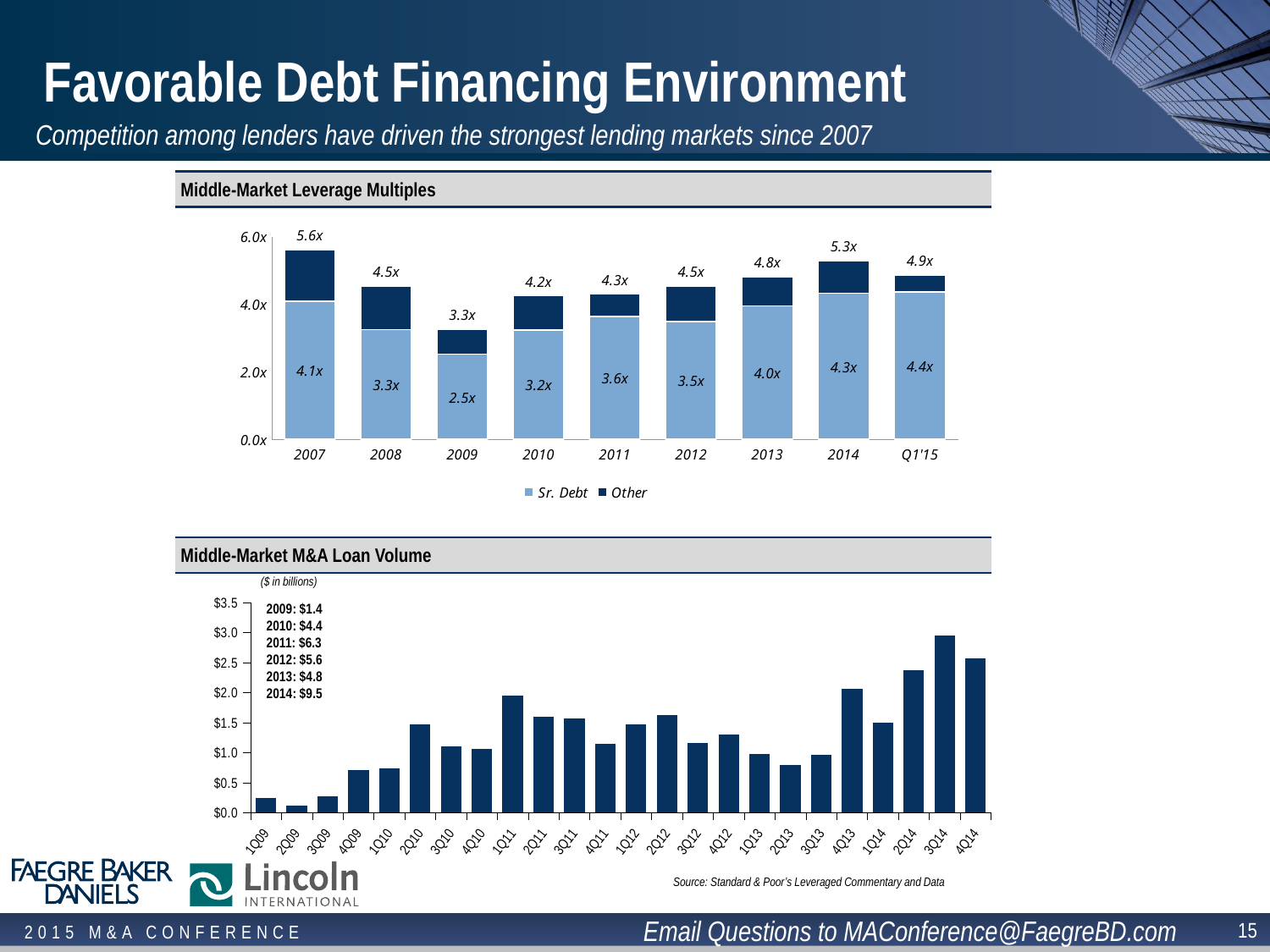
How many quarterly bars are plotted in the Middle-Market M&A Loan Volume chart? 24 In the Middle-Market Leverage Multiples chart, which year has the highest total leverage multiple? 2007 In the Middle-Market Leverage Multiples chart, what is the Sr. Debt value for 2009? 2.5x In the Middle-Market Leverage Multiples chart, what is the total leverage multiple for 2007? 5.6x In the Middle-Market Leverage Multiples chart, which year has the larger Sr. Debt value, 2012 or 2013? 2013 How many series does the legend of the Middle-Market Leverage Multiples chart list? 2 In the Middle-Market M&A Loan Volume chart, is the value for 3Q14 greater or less than $2.5? greater In the Middle-Market Leverage Multiples chart, what is the difference between the total multiple and the Sr. Debt multiple for 2014? 1.0x What kind of chart is the Middle-Market Leverage Multiples chart? Stacked bar chart In the Middle-Market Leverage Multiples chart, which year has the lowest total leverage multiple? 2009 How many periods are shown on the x axis of the Middle-Market Leverage Multiples chart? 9 In the Middle-Market M&A Loan Volume chart, which quarter has the highest loan volume? 3Q14